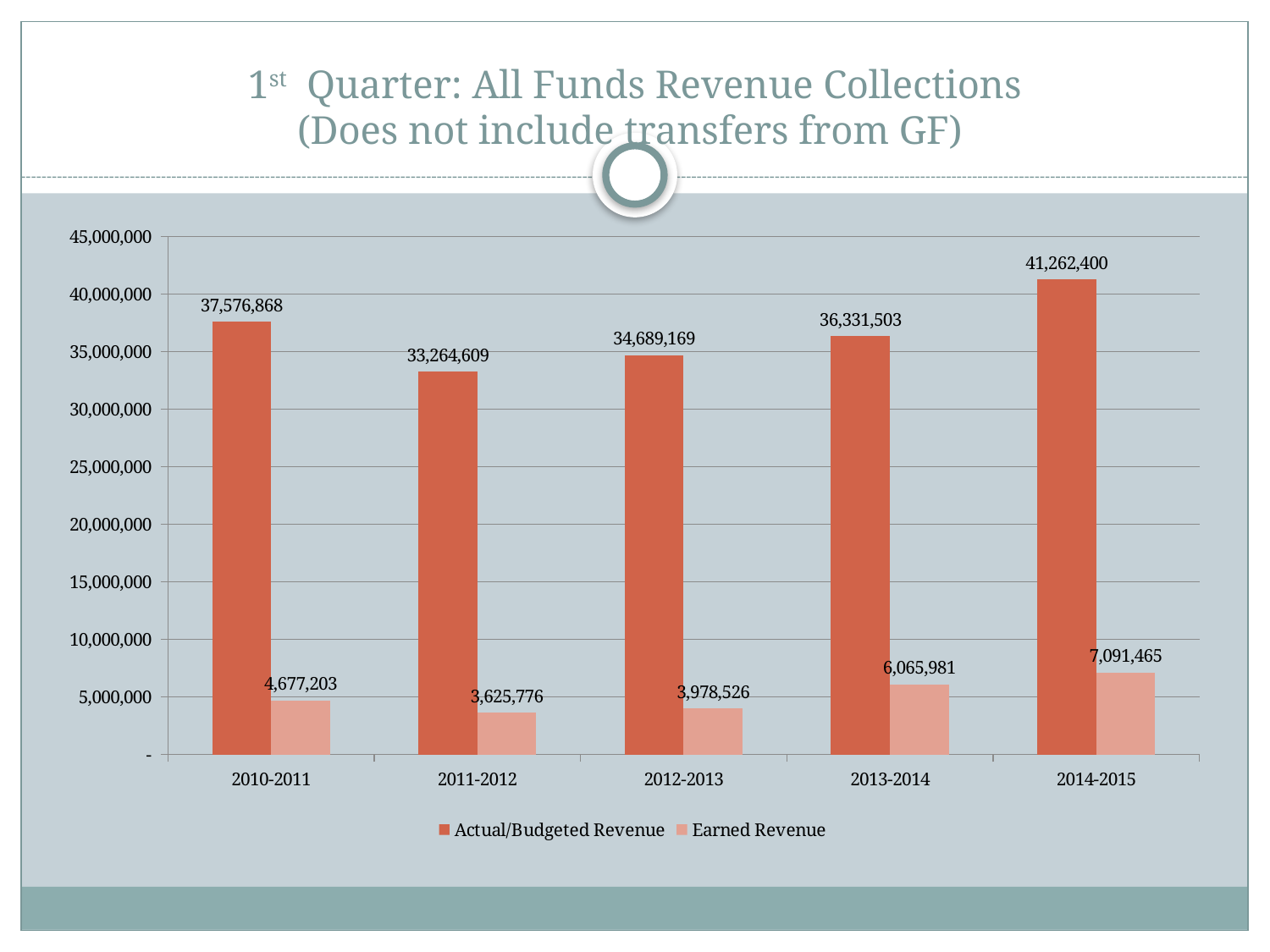
What is the Actual/Budgeted Revenue for 2014-2015? 41,262,400 How many fiscal years are shown on the x axis? 5 Which year has the lowest Earned Revenue? 2011-2012 What is the difference between the Actual/Budgeted Revenue for 2014-2015 and 2013-2014? 4,930,897 Which is larger, the Earned Revenue for 2010-2011 or for 2012-2013? 2010-2011 What is the Earned Revenue for 2013-2014? 6,065,981 What is the Earned Revenue for 2011-2012? 3,625,776 Is the Actual/Budgeted Revenue for 2011-2012 greater or less than 35,000,000? less What kind of chart is shown on the slide? bar chart Which year has the highest Actual/Budgeted Revenue? 2014-2015 How many series does the legend list? 2 Does the Earned Revenue rise or fall from 2011-2012 to 2014-2015? rise